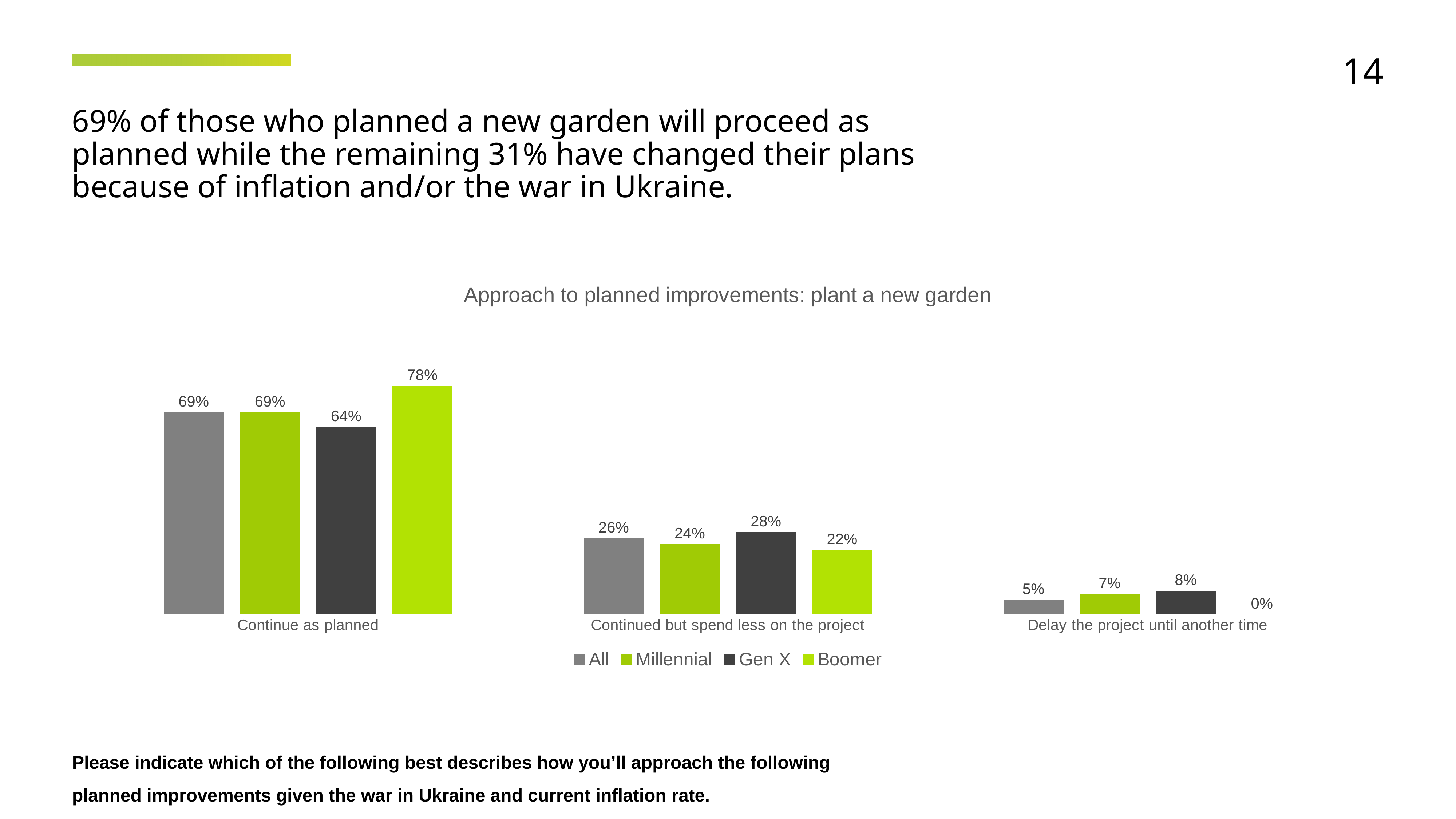
Do the values for the 'All' series rise or fall across the categories from left to right? Fall Which is larger in the 'Delay the project until another time' category: Millennial or Gen X? Gen X What is the difference between the Boomer and Gen X values in the 'Continue as planned' category? 14% How many series does the legend list? 4 What is the value for Boomer in the 'Continue as planned' category? 78% What is the value for Gen X in the 'Continued but spend less on the project' category? 28% How many categories are shown on the x axis? 3 Which series has the highest value in the 'Continue as planned' category? Boomer Which series has the lowest value in the 'Continued but spend less on the project' category? Boomer What is the value for Boomer in the 'Delay the project until another time' category? 0% What is the title of the chart? Approach to planned improvements: plant a new garden What kind of chart is shown on the slide? Bar chart